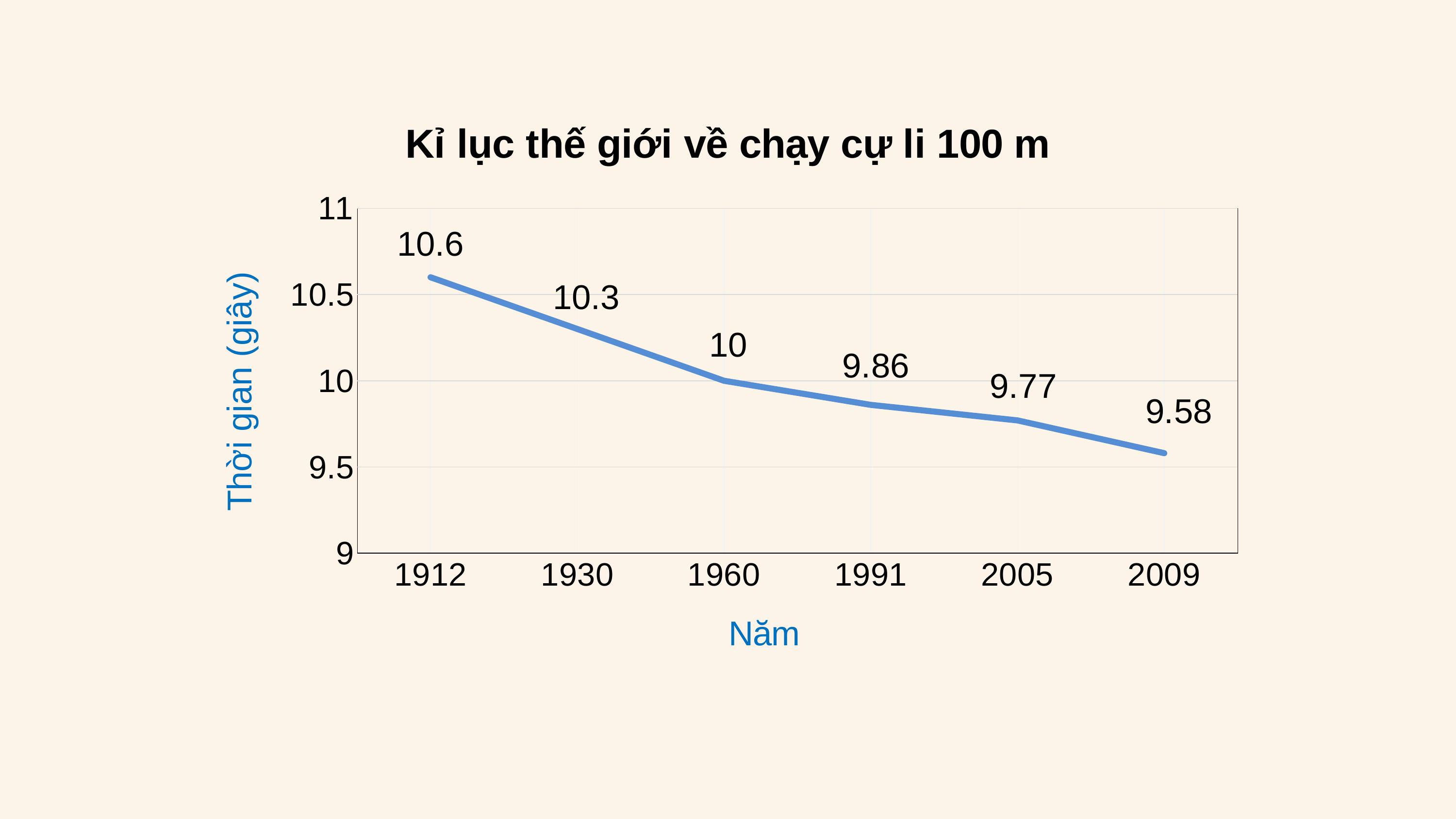
What is the world record time shown for 1912? 10.6 Which year has the lowest value on the chart? 2009 Is the value for 1930 greater or less than 10? greater What is the difference between the values for 1912 and 2009? 1.02 Do the values rise or fall from 1912 to 2009? fall What is the difference between the values for 2005 and 2009? 0.19 What kind of chart is shown on the slide? line chart What is the value plotted for 1991? 9.86 Which is larger, the value for 1930 or the value for 1960? 1930 How many years are plotted on the chart? 6 Which year has the highest value on the chart? 1912 What is the value plotted for 2009? 9.58